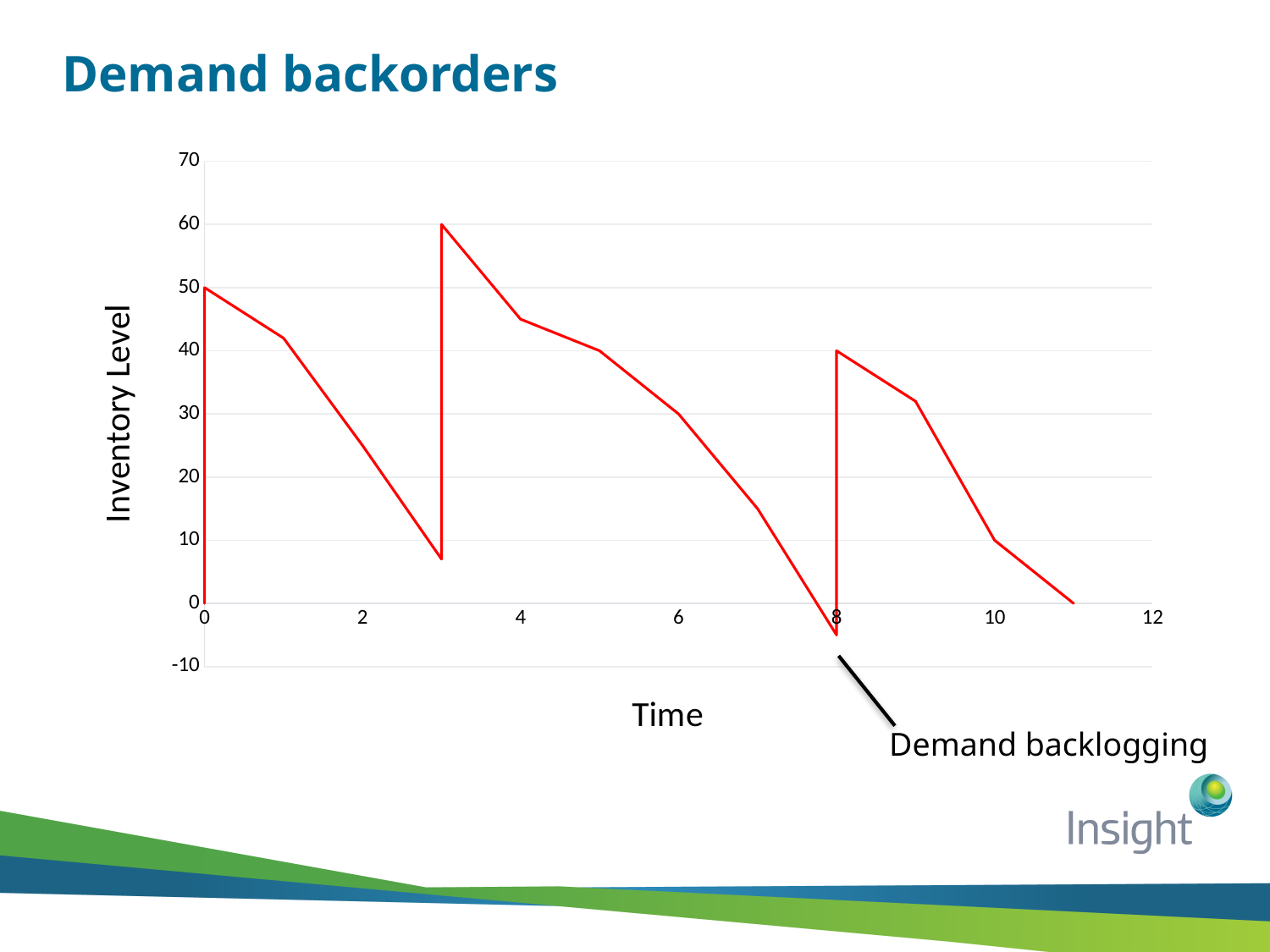
At what time does the inventory level reach its highest value? 3 What is the highest inventory level reached on the chart? 60 What is the inventory level at time 11? 0 What kind of chart is shown on the slide? line chart Between time 8 and time 11, does the inventory level rise or fall? fall Is the inventory level at time 1 greater or less than 40? greater What is the inventory level at time 6? 30 What is the title of the chart? Demand backorders Is the inventory level at time 7 greater or less than 20? less Is the lowest inventory level at time 8 greater or less than 0? less What is the label of the vertical axis? Inventory Level